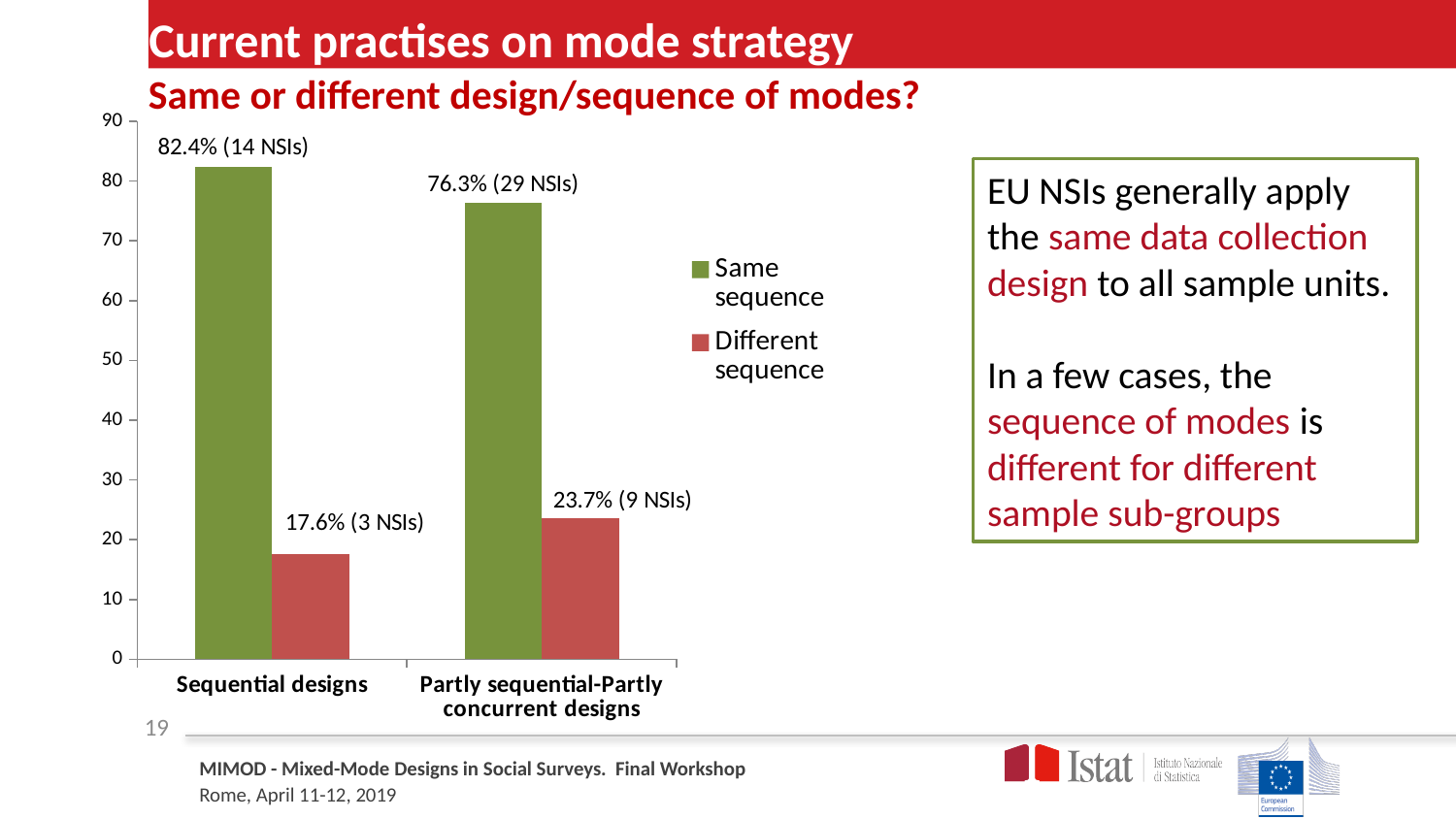
What kind of chart is shown on the slide? Bar chart What is the value for Same sequence in the Sequential designs category? 82.4% (14 NSIs) Which bar has the lowest value on the chart? Different sequence, Sequential designs What is the difference in percentage points between Same sequence and Different sequence for Sequential designs? 64.8 What colour represents the Different sequence series? Red How many series does the legend list? 2 Which is larger: Same sequence for Sequential designs or Same sequence for Partly sequential-Partly concurrent designs? Sequential designs Which bar has the highest value on the chart? Same sequence, Sequential designs What is the value for Same sequence in the Partly sequential-Partly concurrent designs category? 76.3% (29 NSIs) What is the value for Different sequence in the Sequential designs category? 17.6% (3 NSIs) What is the value for Different sequence in the Partly sequential-Partly concurrent designs category? 23.7% (9 NSIs) How many categories are shown on the x axis? 2